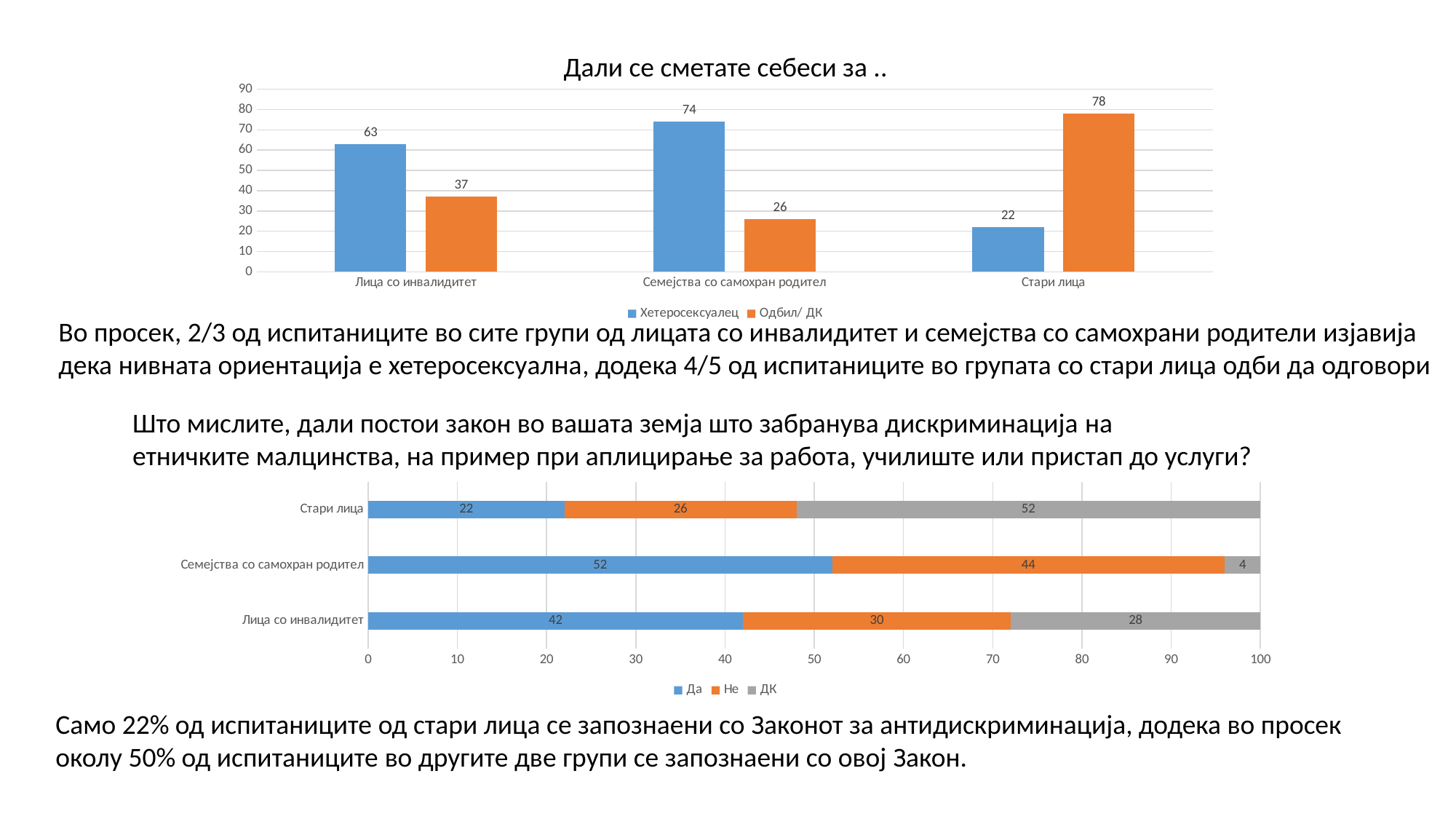
In the top chart 'Дали се сметате себеси за ..', what is the difference between Хетеросексуалец and Одбил/ ДК for Лица со инвалидитет? 26 In the top chart 'Дали се сметате себеси за ..', how many series does the legend list? 2 In the bottom chart, what is the value for Не for Стари лица? 26 In the bottom chart, which category has the highest Да value? Семејства со самохран родител In the bottom chart, what is the total of the stacked bar for Лица со инвалидитет? 100 In the top chart 'Дали се сметате себеси за ..', which category has the lowest Одбил/ ДК value? Семејства со самохран родител In the top chart 'Дали се сметате себеси за ..', which category has the highest Хетеросексуалец value? Семејства со самохран родител In the bottom chart, how many series does the legend list? 3 What kind of chart is the bottom chart on the slide? Stacked bar chart In the top chart 'Дали се сметате себеси за ..', what is the value for Одбил/ ДК for Стари лица? 78 In the top chart 'Дали се сметате себеси за ..', what is the value for Хетеросексуалец for Семејства со самохран родител? 74 In the bottom chart, what is the value for ДК for Семејства со самохран родител? 4